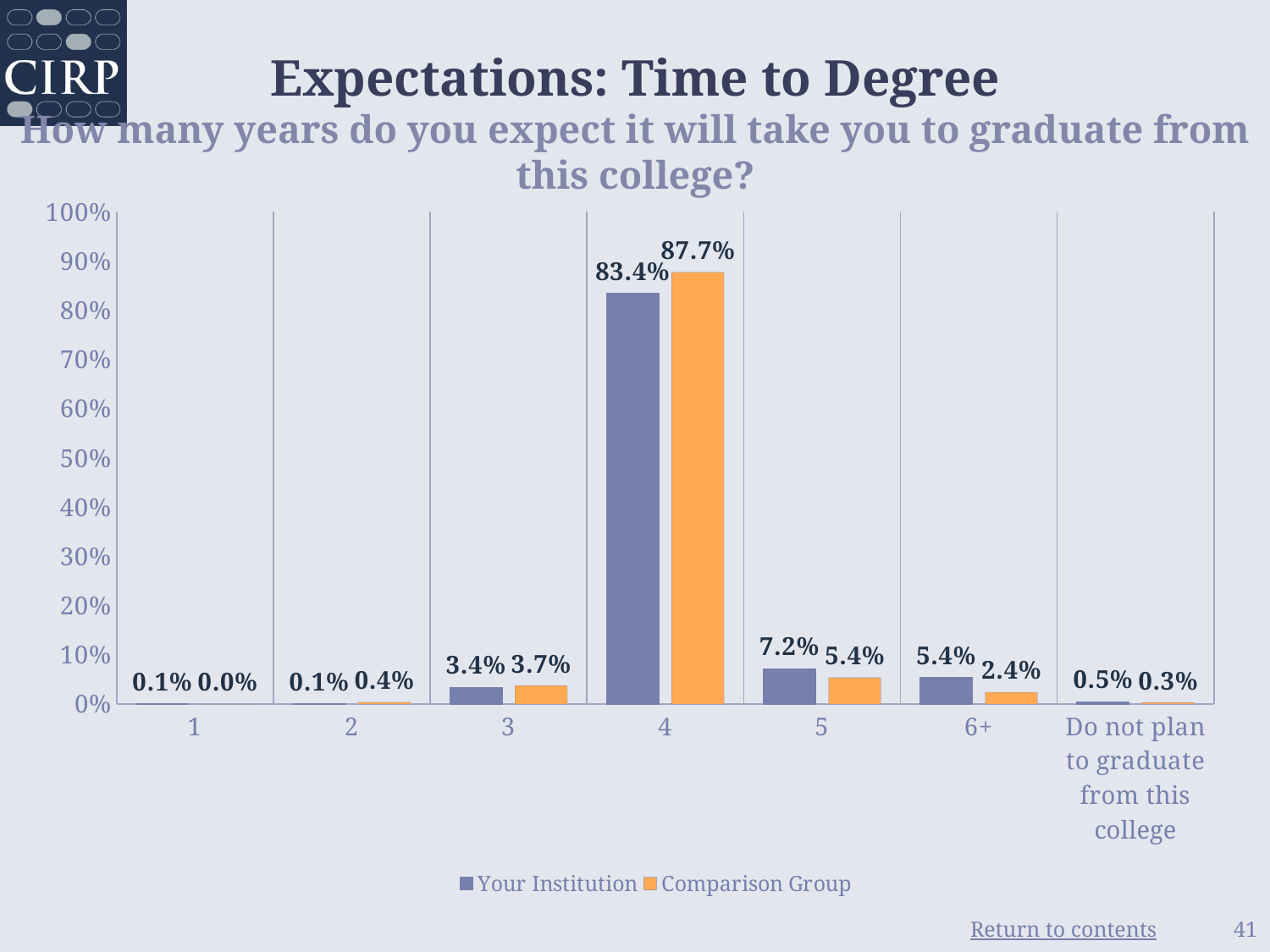
How many series does the legend list? 2 What is the value for Your Institution for the category 5? 7.2% For the category 6+, which series has the larger value, Your Institution or Comparison Group? Your Institution What is the value for Comparison Group for the category 6+? 2.4% What is the value for Comparison Group for the category 'Do not plan to graduate from this college'? 0.3% What kind of chart is shown on the slide? bar chart What is the value for Your Institution for the category 4? 83.4% Is the value for Comparison Group for the category 4 greater or less than 80%? greater Which category has the lowest value for Comparison Group? 1 What is the difference between the Comparison Group and Your Institution values for the category 4? 4.3% Which category has the highest value for Comparison Group? 4 How many categories are shown on the x axis? 7